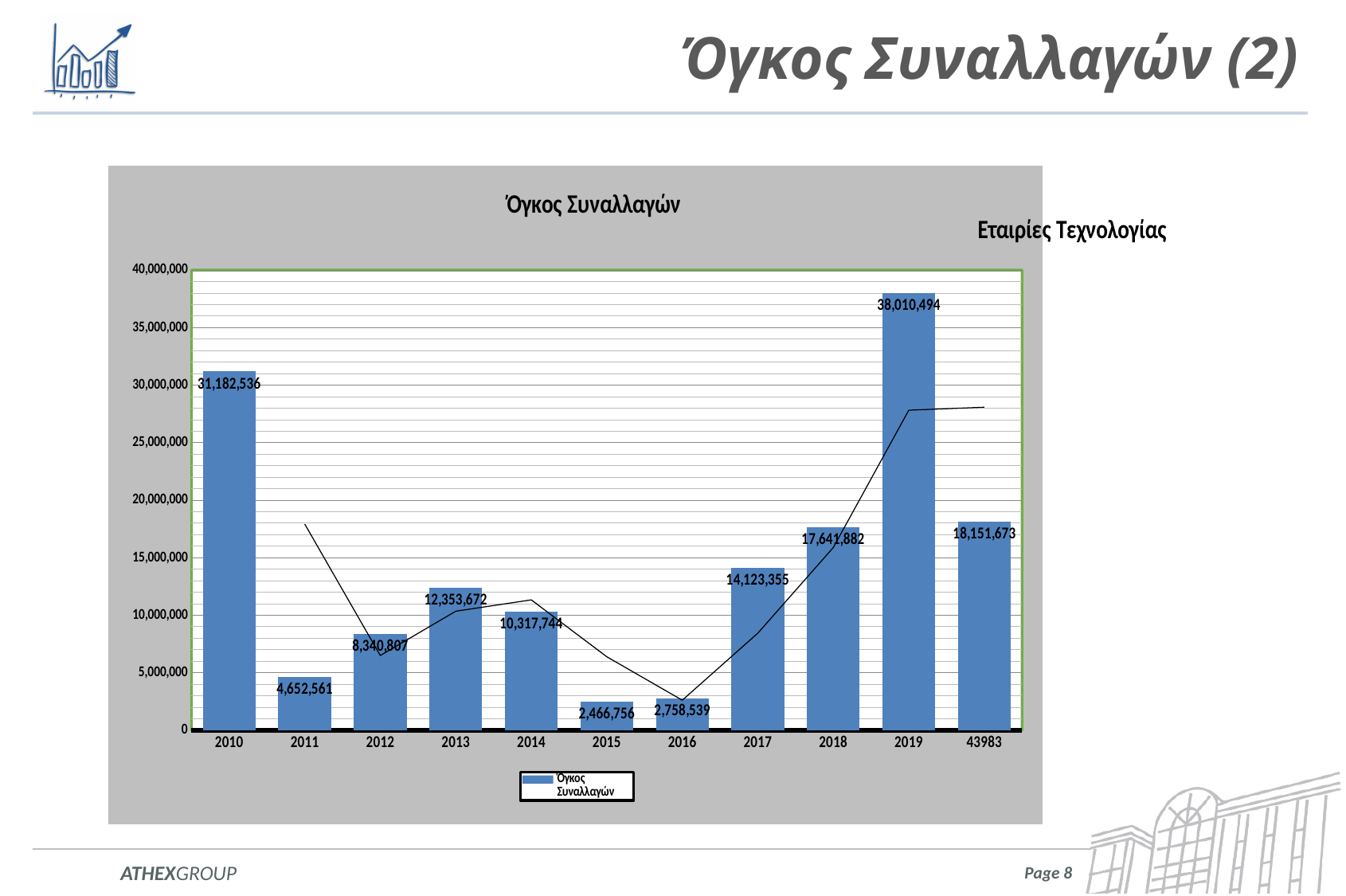
Is the value for 2012 greater or less than 10,000,000? less How many categories are shown on the x axis? 11 Which year has the highest value? 2019 Which is larger, the value for 2013 or the value for 2014? 2013 Which category has the lowest value? 2015 How many series does the legend list? 1 What is the value for 2015? 2,466,756 What is the difference between the values for 2018 and 2017? 3,518,527 What is the value for 2013? 12,353,672 What is the difference between the values for 2019 and 2010? 6,827,958 What is the value for 2019? 38,010,494 What is the title of the chart? Όγκος Συναλλαγών